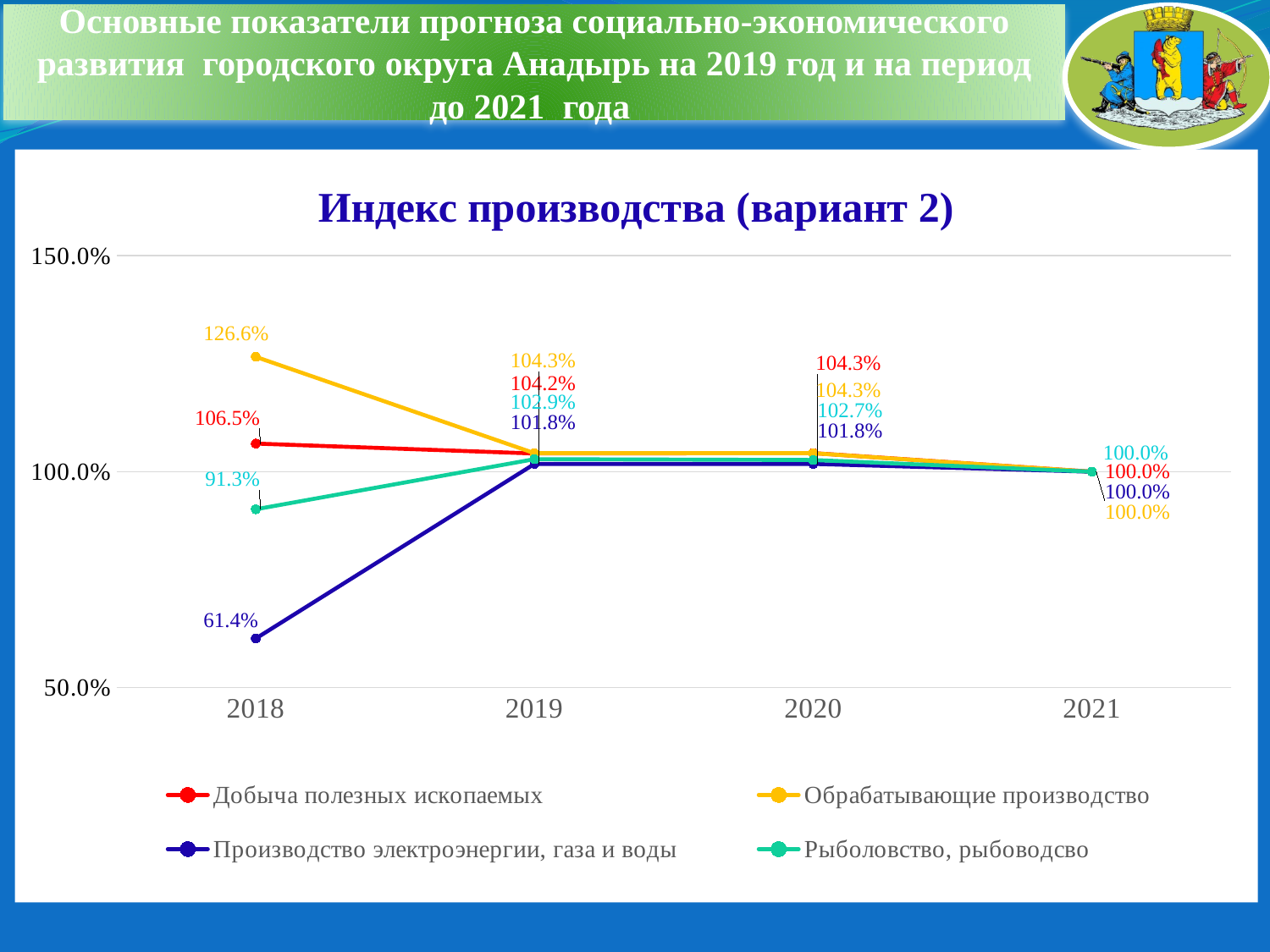
What is the value for Обрабатывающие производство in 2018? 126.6% What is the title of the chart? Индекс производства (вариант 2) What type of chart is shown on the slide? line chart How many series does the legend list? 4 What is the value for Добыча полезных ископаемых in 2020? 104.3% Does the value for Производство электроэнергии, газа и воды rise or fall from 2018 to 2019? rise How many years are shown on the x axis? 4 Which series has the highest value in 2018? Обрабатывающие производство Which series has the lowest value in 2018? Производство электроэнергии, газа и воды What is the difference between the 2018 values of Обрабатывающие производство and Добыча полезных ископаемых? 20.1% What is the value for Рыболовство, рыбоводсво in 2019? 102.9% What is the value for Производство электроэнергии, газа и воды in 2018? 61.4%